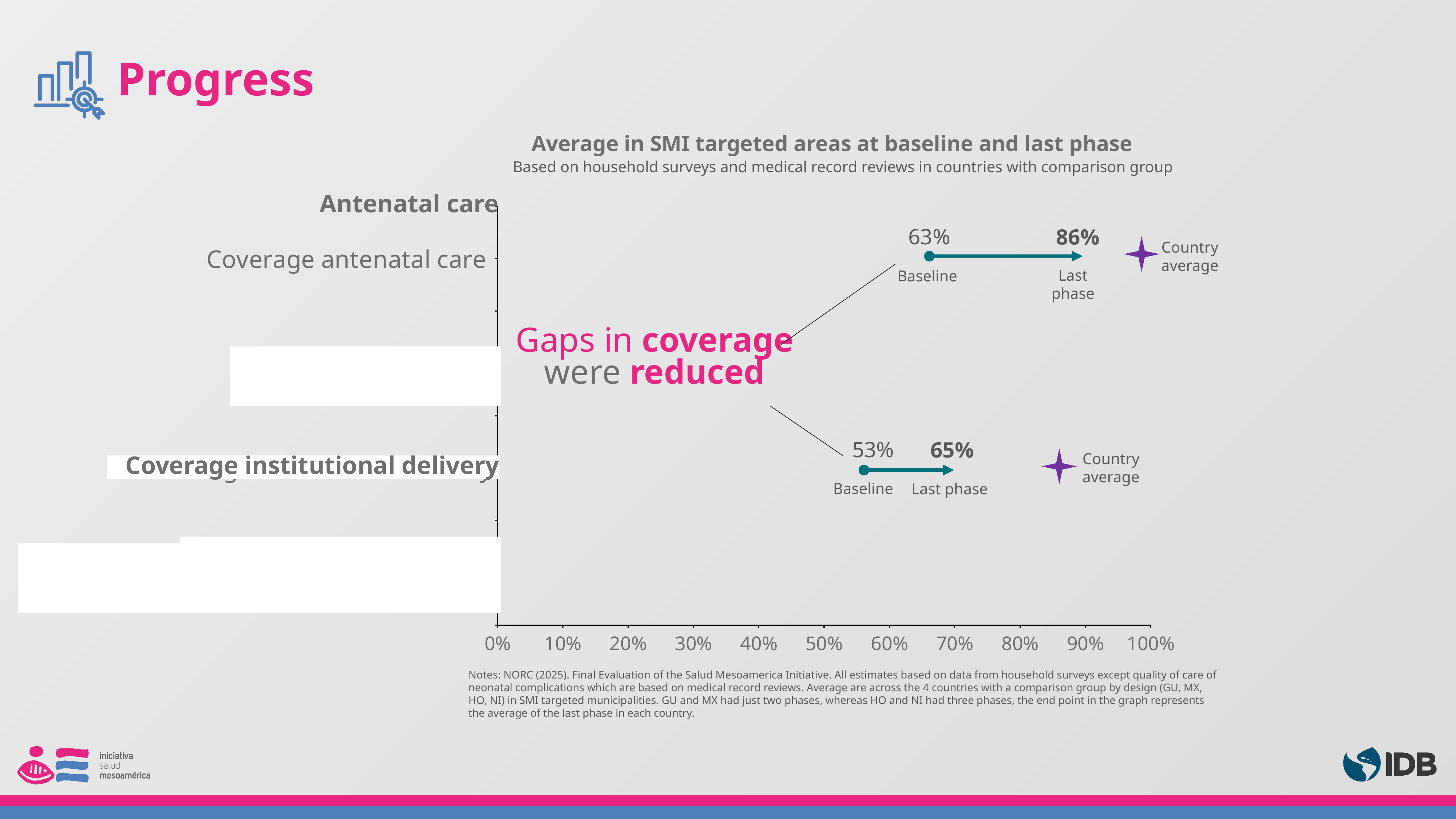
What is the last phase value for Coverage institutional delivery? 65% Is the Country average for Coverage institutional delivery greater or less than 80%? greater Is the Country average for Coverage antenatal care greater or less than 90%? greater Which indicator has the lower baseline value? Coverage institutional delivery What is the last phase value for Coverage antenatal care? 86% What is the baseline value for Coverage institutional delivery? 53% Do the values for each indicator rise or fall from baseline to last phase? rise Which indicator has the higher last phase value, Coverage antenatal care or Coverage institutional delivery? Coverage antenatal care By how many percentage points did Coverage antenatal care increase from baseline to last phase? 23 percentage points What is the baseline value for Coverage antenatal care? 63% By how many percentage points did Coverage institutional delivery increase from baseline to last phase? 12 percentage points What is the title of the chart? Average in SMI targeted areas at baseline and last phase